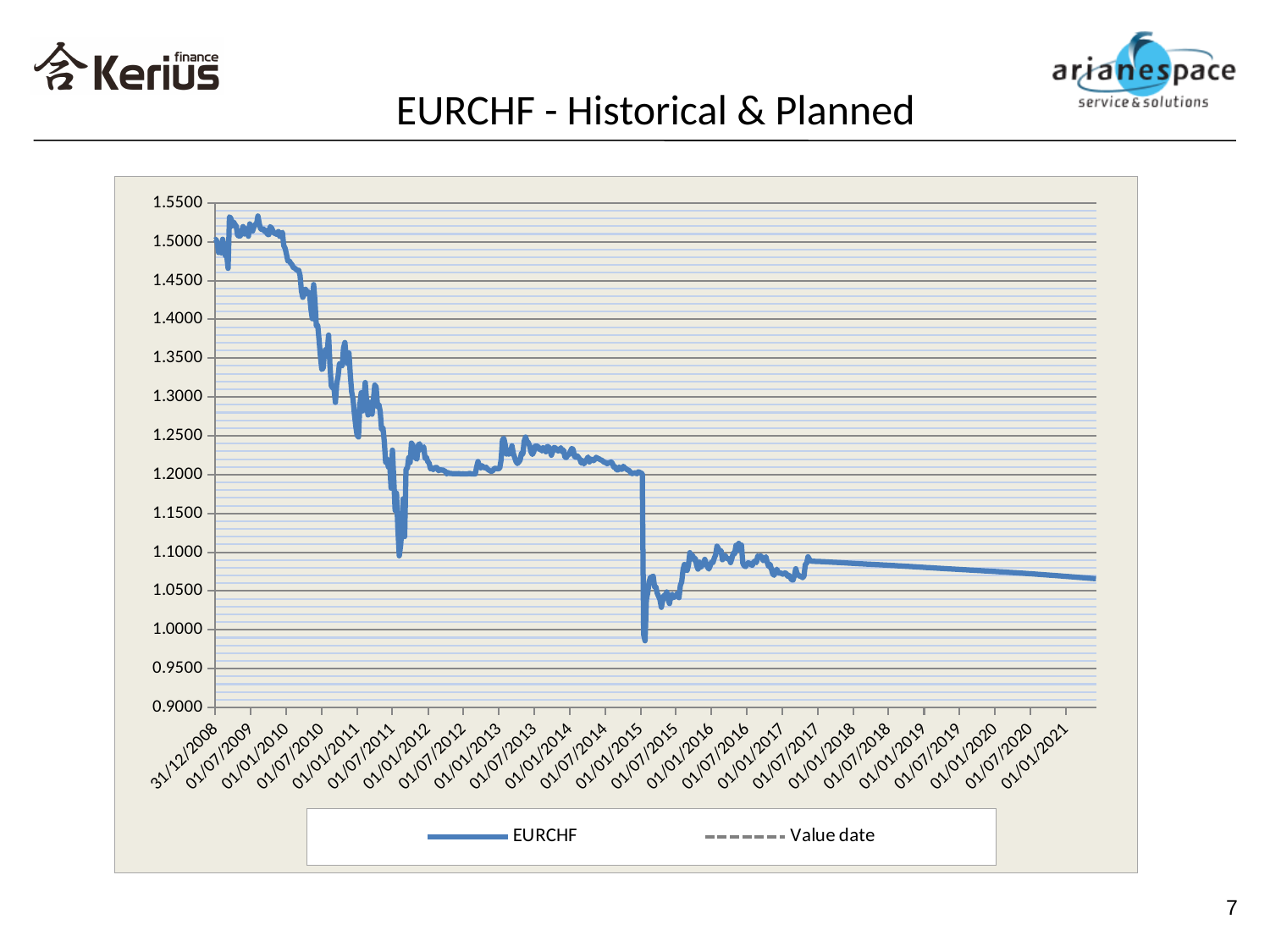
What is the title of the chart? EURCHF - Historical & Planned Is the EURCHF value at 01/01/2021 greater or less than 1.1000? less How many series does the legend list? 2 What kind of chart is shown on the slide? Line chart Is the EURCHF value at 31/12/2008 greater or less than 1.4000? greater What are the two entries in the chart legend? EURCHF and Value date Is the EURCHF value at 01/01/2010 greater or less than 1.4500? greater What is the highest value shown on the vertical axis? 1.5500 Overall, does the EURCHF line rise or fall from 31/12/2008 to 01/01/2021? fall Is the EURCHF value at 31/12/2008 larger or smaller than the value at 01/01/2021? larger